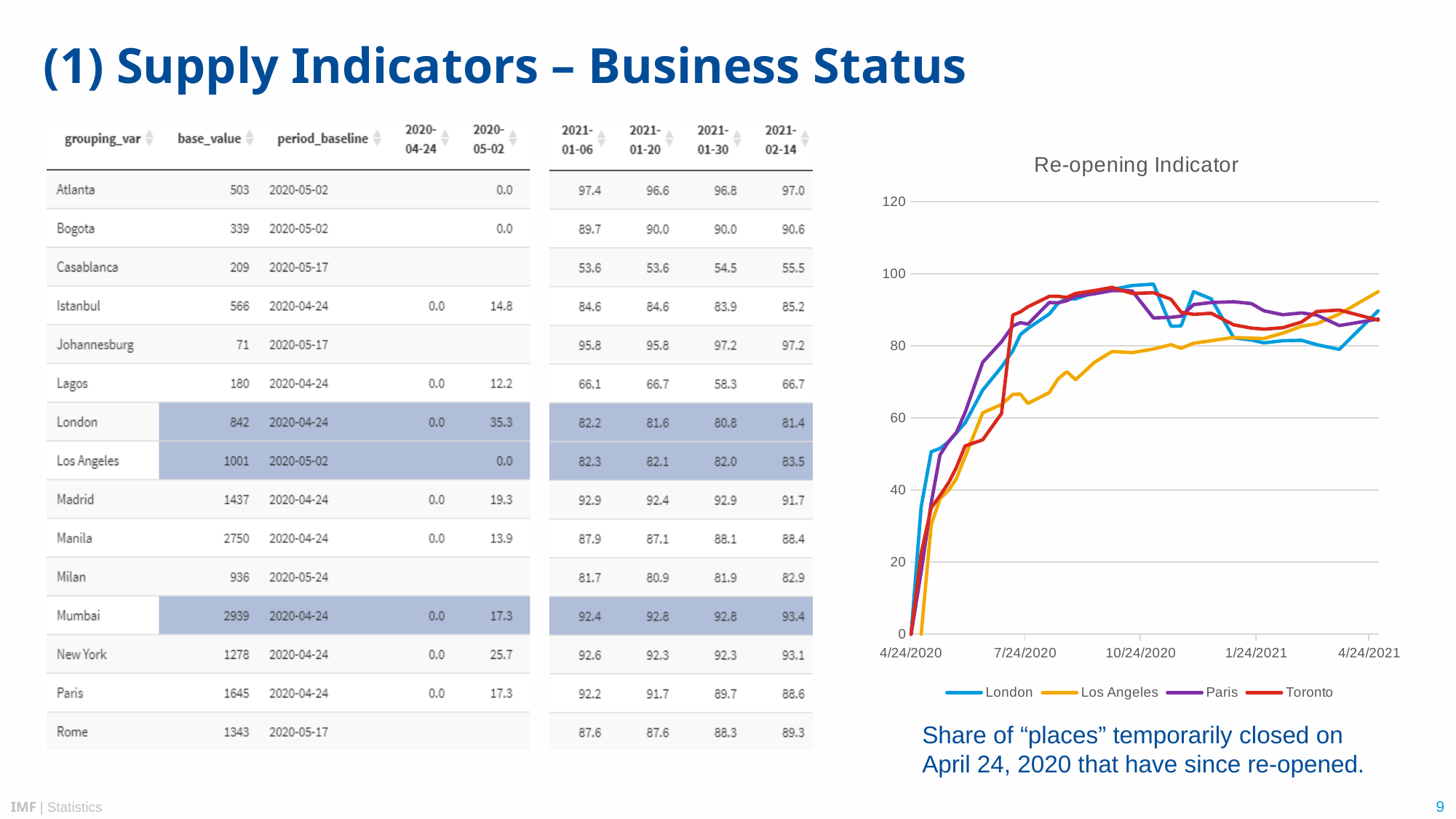
In the Re-opening Indicator chart, what value do all four lines start at on 4/24/2020? 0 In the Re-opening Indicator chart, is the value for Paris at 10/24/2020 greater or less than 80? greater What is the title of the line chart on the slide? Re-opening Indicator Which cities are listed in the legend of the Re-opening Indicator chart? London, Los Angeles, Paris, Toronto In the Re-opening Indicator chart, which series has the highest value at 4/24/2021? Los Angeles In the Re-opening Indicator chart, which series has the lowest value at 7/24/2020? Los Angeles What kind of chart is the Re-opening Indicator chart? line chart In the Re-opening Indicator chart, do the values generally rise or fall from 4/24/2020 to 4/24/2021? rise In the Re-opening Indicator chart, is the value for Los Angeles at 7/24/2020 greater or less than 80? less How many series does the legend of the Re-opening Indicator chart list? 4 In the Re-opening Indicator chart, is the value for Toronto at 1/24/2021 greater or less than 60? greater